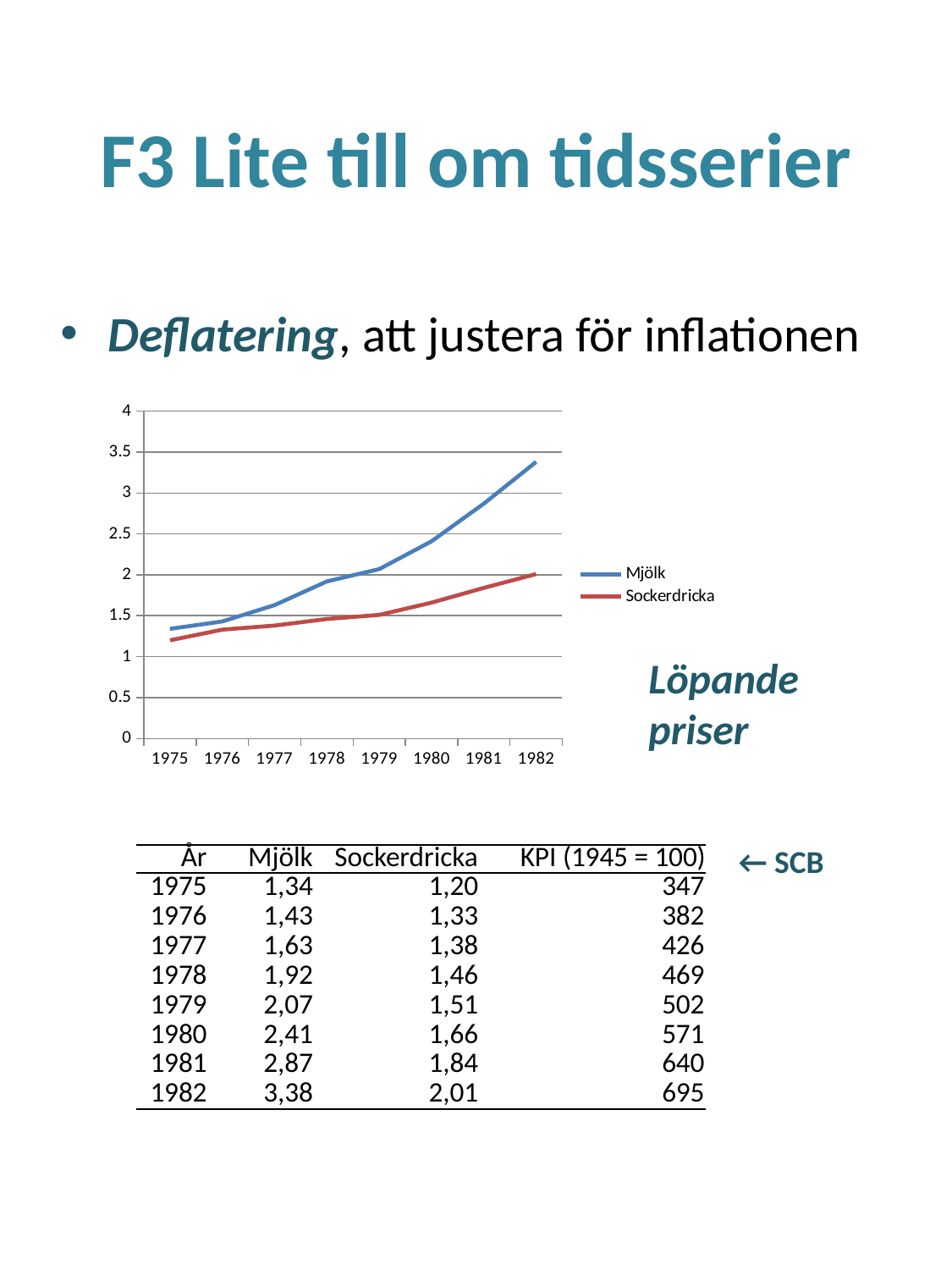
Which series is plotted with the blue line? Mjölk How many years are plotted along the x axis of the chart? 8 What kind of chart is shown on the slide? line chart In which year does the Mjölk series reach its highest value? 1982 In which year does the Sockerdricka series have its lowest value? 1975 Does the Mjölk line rise or fall from 1975 to 1982? rises In 1982, which series has the higher value, Mjölk or Sockerdricka? Mjölk Is the value for Sockerdricka in 1979 greater or less than 2? less According to the table on the slide, what is the difference between the Mjölk and Sockerdricka values in 1982? 1,37 According to the table on the slide, what is the value for Mjölk in 1980? 2,41 How many series does the chart's legend list? 2 Is the value for Mjölk in 1982 greater or less than 3? greater